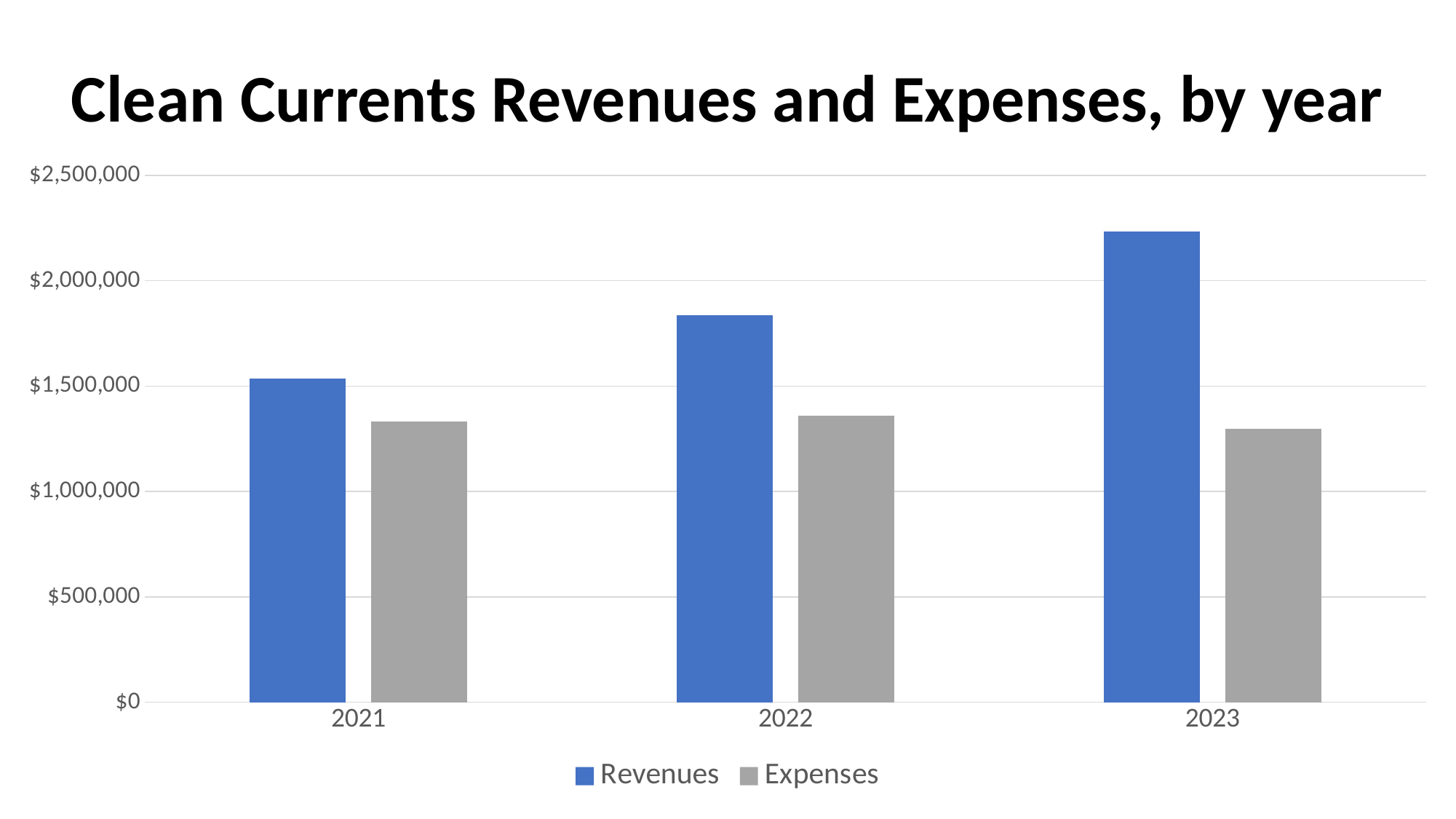
What is the title of the chart? Clean Currents Revenues and Expenses, by year Which year has the highest Revenues? 2023 Is the value for Expenses in 2022 greater or less than $1,500,000? less What kind of chart is shown on the slide? bar chart Which year has the lowest Revenues? 2021 How many series does the legend list? 2 How many years are shown on the x axis? 3 In 2021, which is larger, Revenues or Expenses? Revenues In 2023, which is larger, Revenues or Expenses? Revenues Is the value for Revenues in 2022 greater or less than $1,500,000? greater Do Revenues rise or fall from 2021 to 2023? rise Is the value for Revenues in 2023 greater or less than $2,000,000? greater